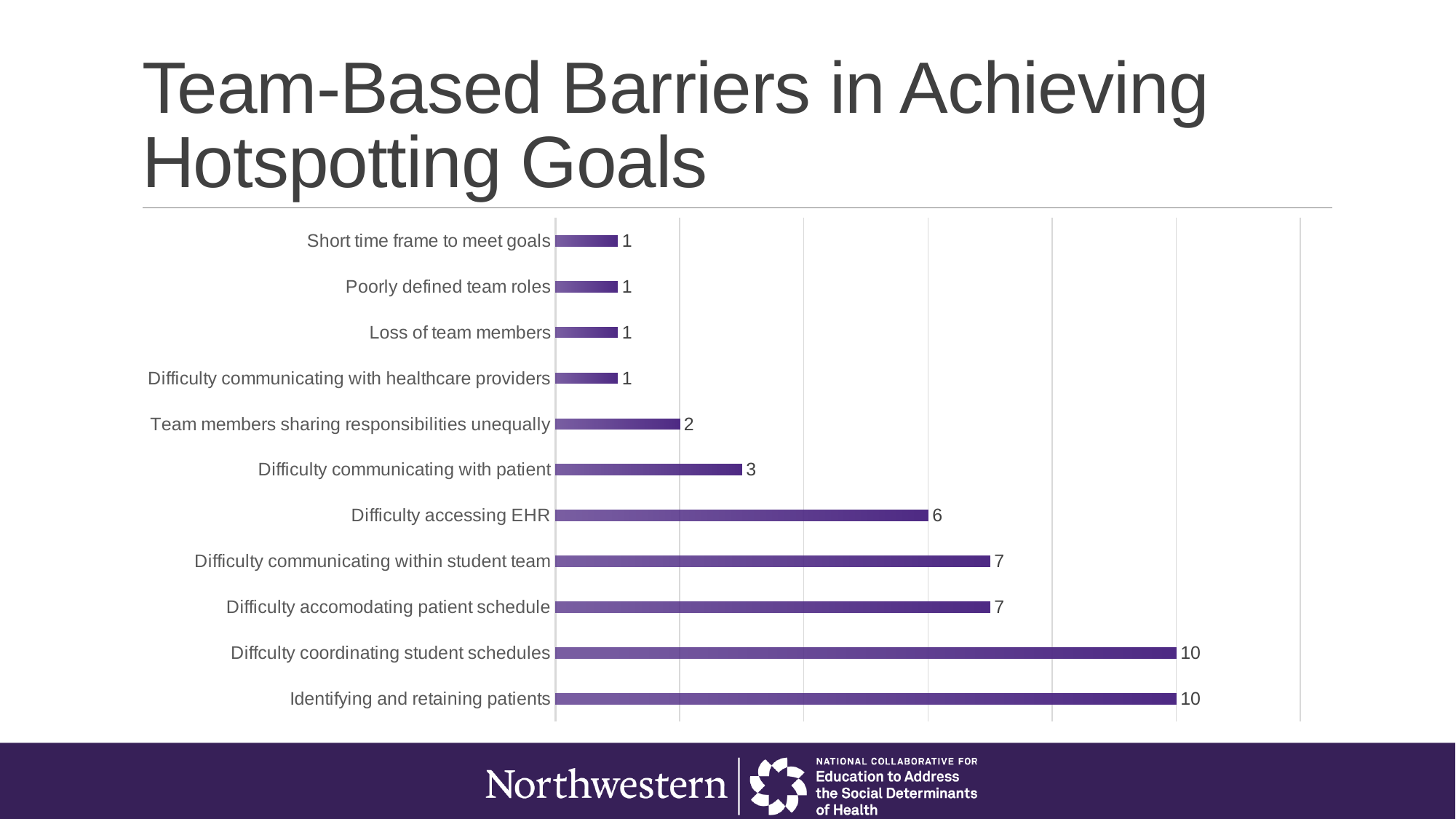
What kind of chart is shown on the slide? Bar chart What is the highest value shown on the chart? 10 What is the value for Difficulty accessing EHR? 6 What is the value for Difficulty accomodating patient schedule? 7 What is the value for Team members sharing responsibilities unequally? 2 How many categories are shown on the chart? 11 What is the difference between the values for Diffculty coordinating student schedules and Difficulty communicating within student team? 3 What is the lowest value shown on the chart? 1 Which has a larger value, Difficulty accessing EHR or Difficulty communicating with patient? Difficulty accessing EHR What is the value for Difficulty communicating with patient? 3 What is the title of the slide? Team-Based Barriers in Achieving Hotspotting Goals What is the value for Identifying and retaining patients? 10